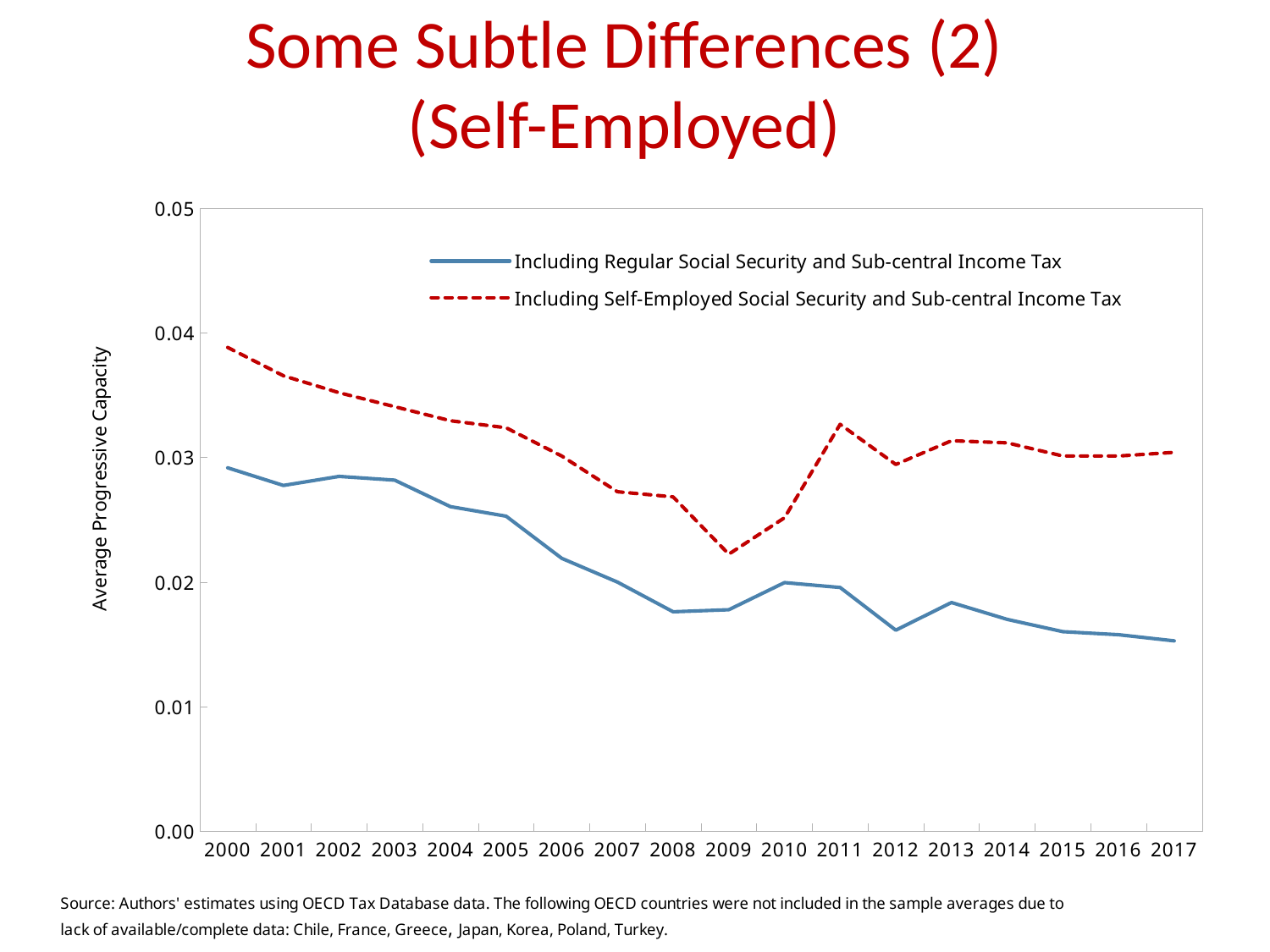
Is the value for 2000 in the 'Including Self-Employed Social Security and Sub-central Income Tax' series greater or less than 0.04? less In which year is the 'Including Self-Employed Social Security and Sub-central Income Tax' series at its lowest? 2009 Is the value for 2011 in the 'Including Self-Employed Social Security and Sub-central Income Tax' series greater or less than 0.03? greater Is the value for 2017 in the 'Including Regular Social Security and Sub-central Income Tax' series greater or less than 0.02? less How many series does the legend list? 2 What kind of chart is shown on the slide? line chart How many years are plotted along the x axis? 18 In 2010, which series has the higher value? Including Self-Employed Social Security and Sub-central Income Tax In which year is the 'Including Self-Employed Social Security and Sub-central Income Tax' series at its highest? 2000 What is the label of the y axis? Average Progressive Capacity Which series is drawn with a red dashed line? Including Self-Employed Social Security and Sub-central Income Tax